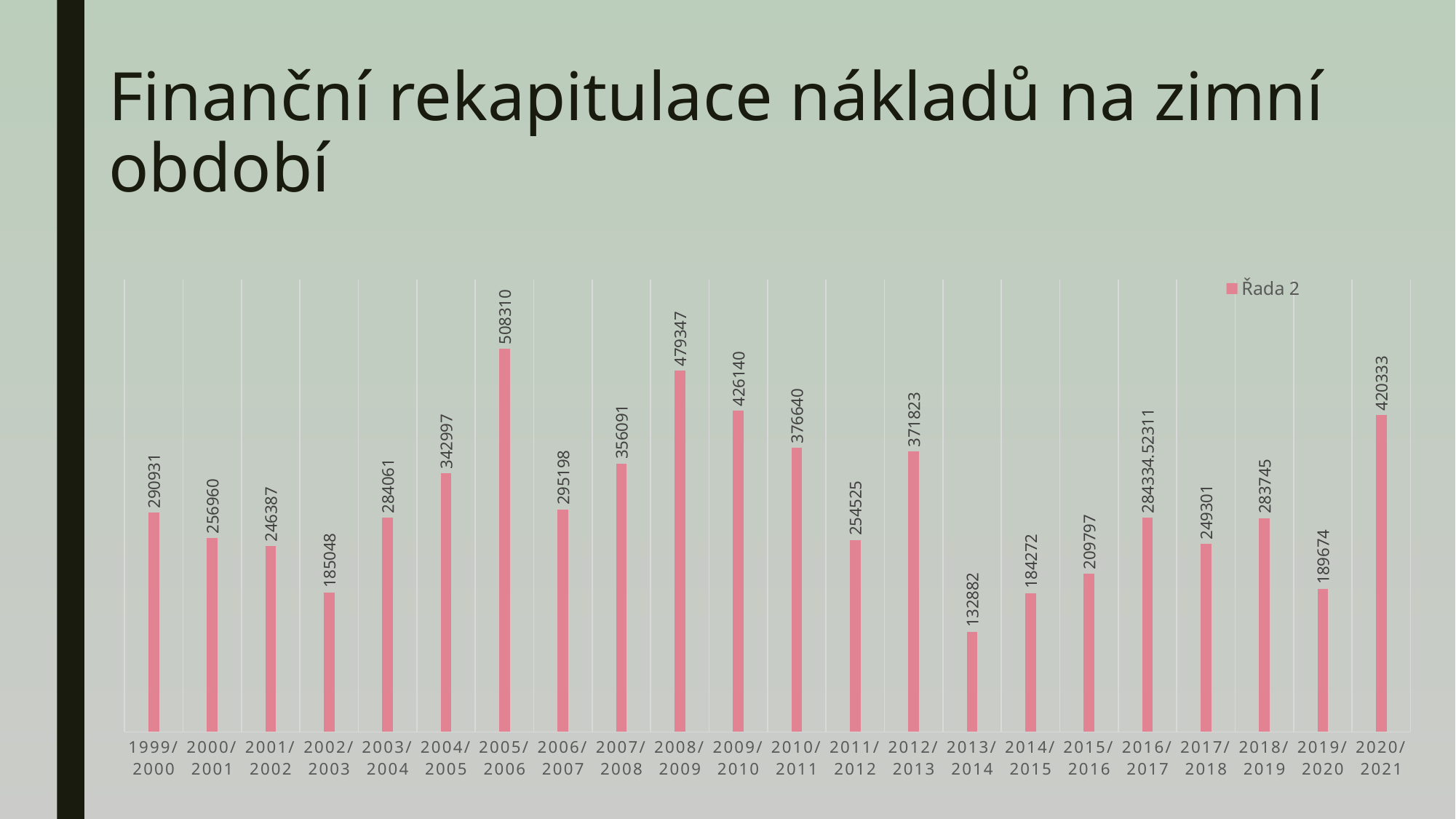
What is the difference between the values for 2005/2006 and 2008/2009? 28963 What is the value for 2013/2014? 132882 Which period has the lowest value? 2013/2014 What is the value for 2005/2006? 508310 What is the difference between the values for 2020/2021 and 2019/2020? 230659 What is the value for 2016/2017? 284334.52311 How many periods are shown on the x axis? 22 Which is larger, the value for 2004/2005 or the value for 2007/2008? 2007/2008 How many series does the legend list? 1 Which period has the highest value? 2005/2006 What kind of chart is shown on the slide? bar chart What is the value for 2020/2021? 420333